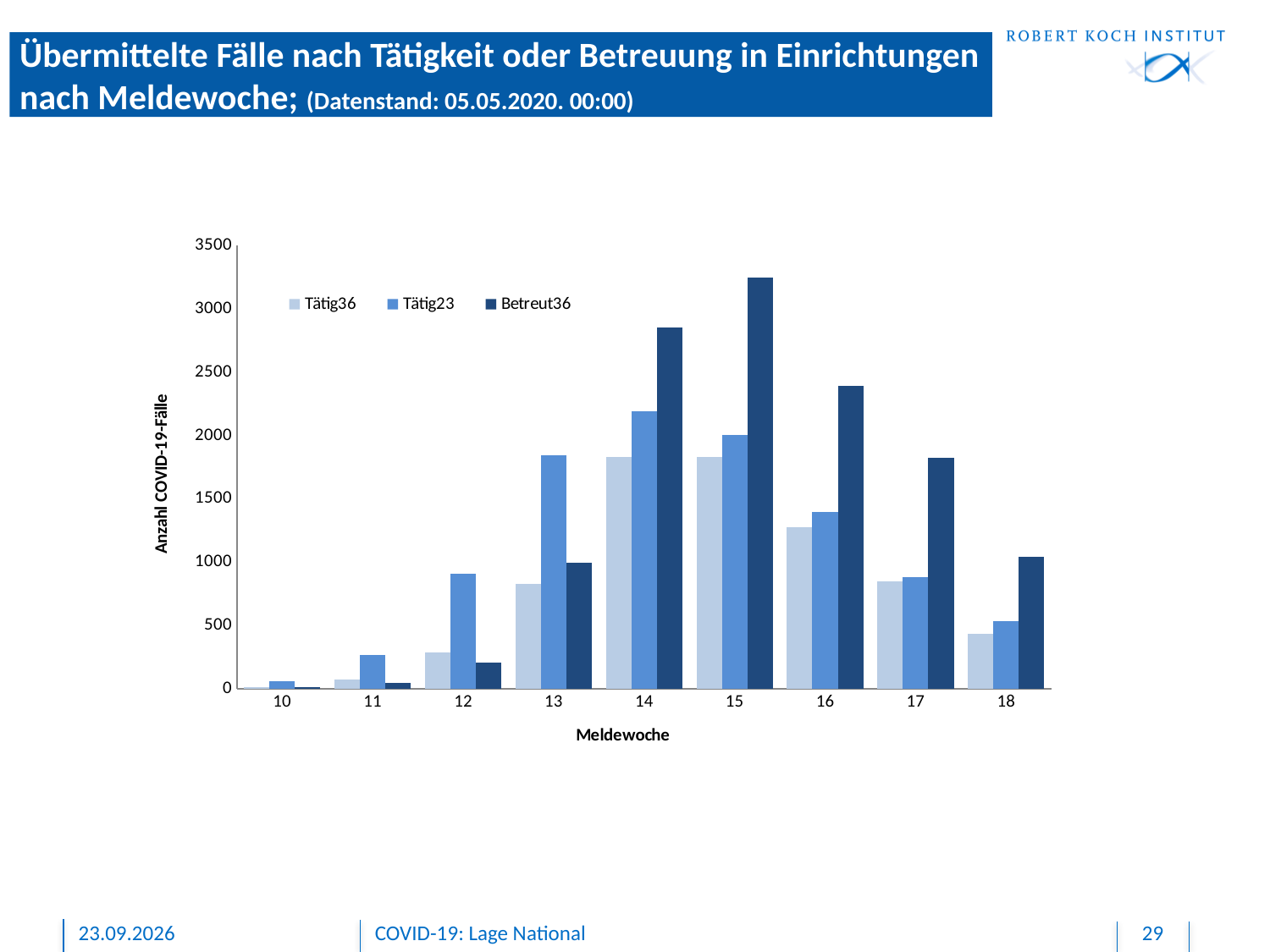
What is the label of the x axis? Meldewoche How many series does the legend list? 3 Is the Tätig23 value for Meldewoche 12 greater or less than 1000? less How many Meldewoche categories are shown on the x axis? 9 In which Meldewoche is the Tätig23 value highest? 14 In Meldewoche 13, which is larger: Tätig23 or Betreut36? Tätig23 Is the Betreut36 value for Meldewoche 15 greater or less than 3000? greater In which Meldewoche is the Tätig23 value lowest? 10 In which Meldewoche is the Betreut36 value highest? 15 What kind of chart is shown on the slide? bar chart Do the Betreut36 values rise or fall from Meldewoche 15 to Meldewoche 18? fall In Meldewoche 16, which is larger: Tätig36 or Betreut36? Betreut36